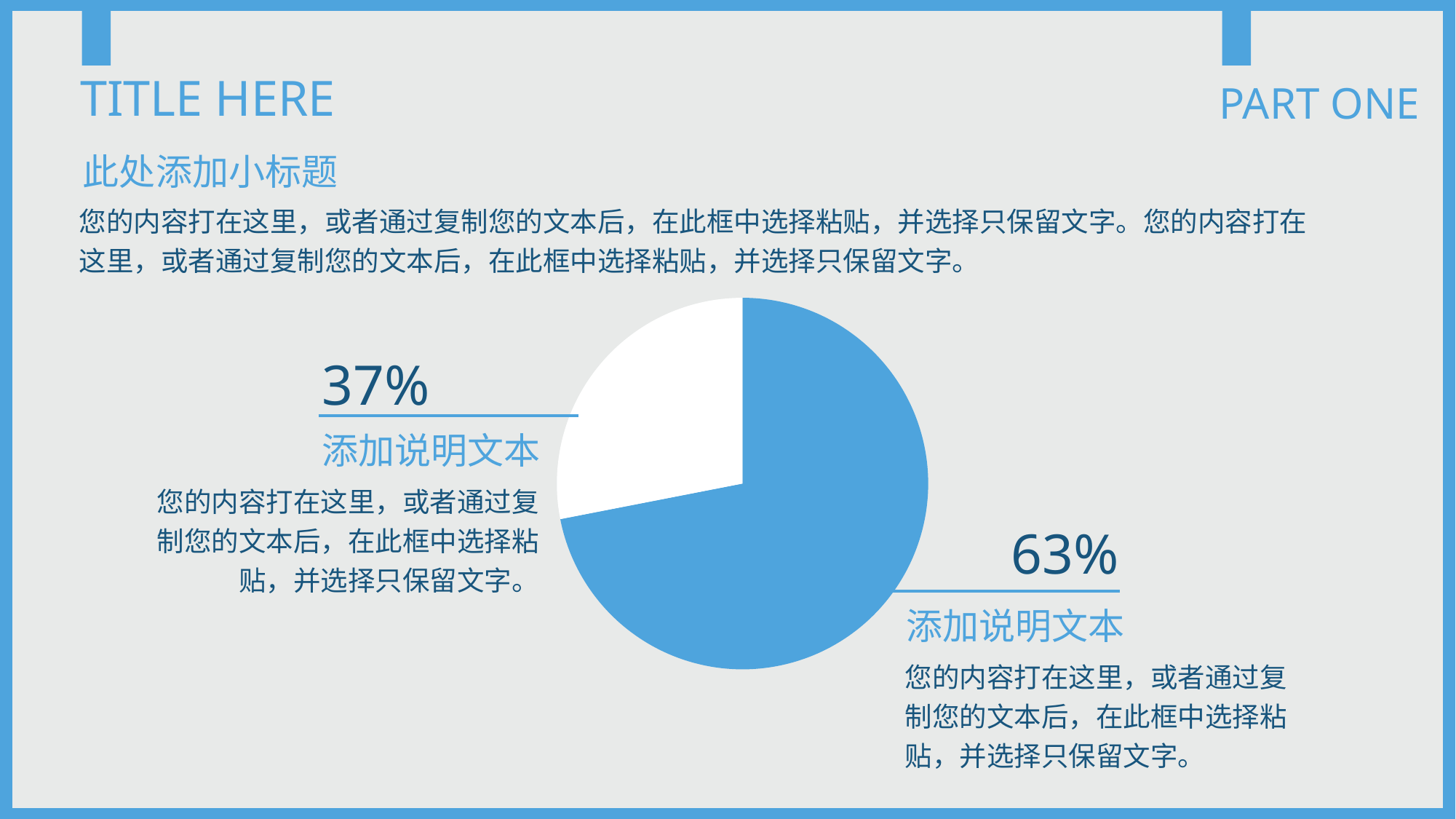
What percentage is shown for the white slice of the pie chart? 37% How many slices does the pie chart have? 2 Which is larger, the blue slice or the white slice of the pie chart? the blue slice Is the blue slice of the pie chart greater or less than 50%? greater What kind of chart is shown on the slide? pie chart What is the difference between the two percentages shown on the pie chart? 26 percentage points Which slice of the pie chart is the largest? the blue slice (63%) What share of the pie does the white slice represent? 37% Which slice of the pie chart is the smallest? the white slice (37%) What percentage is shown for the blue slice of the pie chart? 63% What colour is the larger slice of the pie chart? blue What do the two percentages on the pie chart add up to? 100%